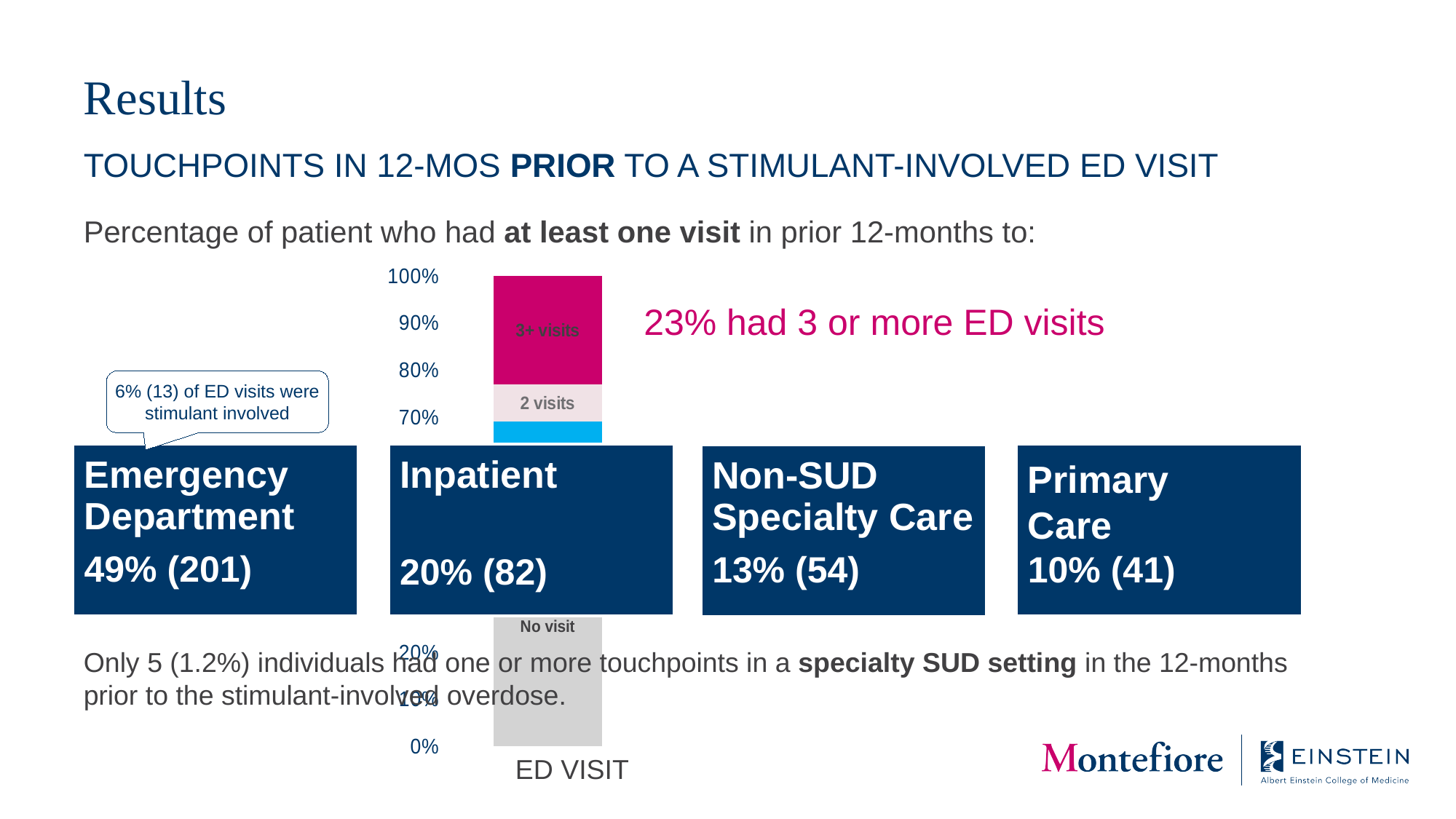
How many categories are plotted on the x axis of the chart? 1 What is the highest value shown on the y axis of the chart? 100% Which segment is larger, '3+ visits' or '2 visits'? 3+ visits What is the category label on the x axis of the chart? ED VISIT Is the lower boundary of the '3+ visits' segment greater or less than 70%? greater What kind of chart is shown on the slide? Stacked bar chart What is the total height of the stacked bar on the y axis? 100% Which segment is at the top of the stacked bar? 3+ visits Is the top of the '2 visits' segment greater or less than 80%? less Is the top of the 'No visit' segment greater or less than 20%? greater What percentage of patients had 3 or more ED visits, according to the annotation next to the chart? 23% Which segment is at the bottom of the stacked bar? No visit